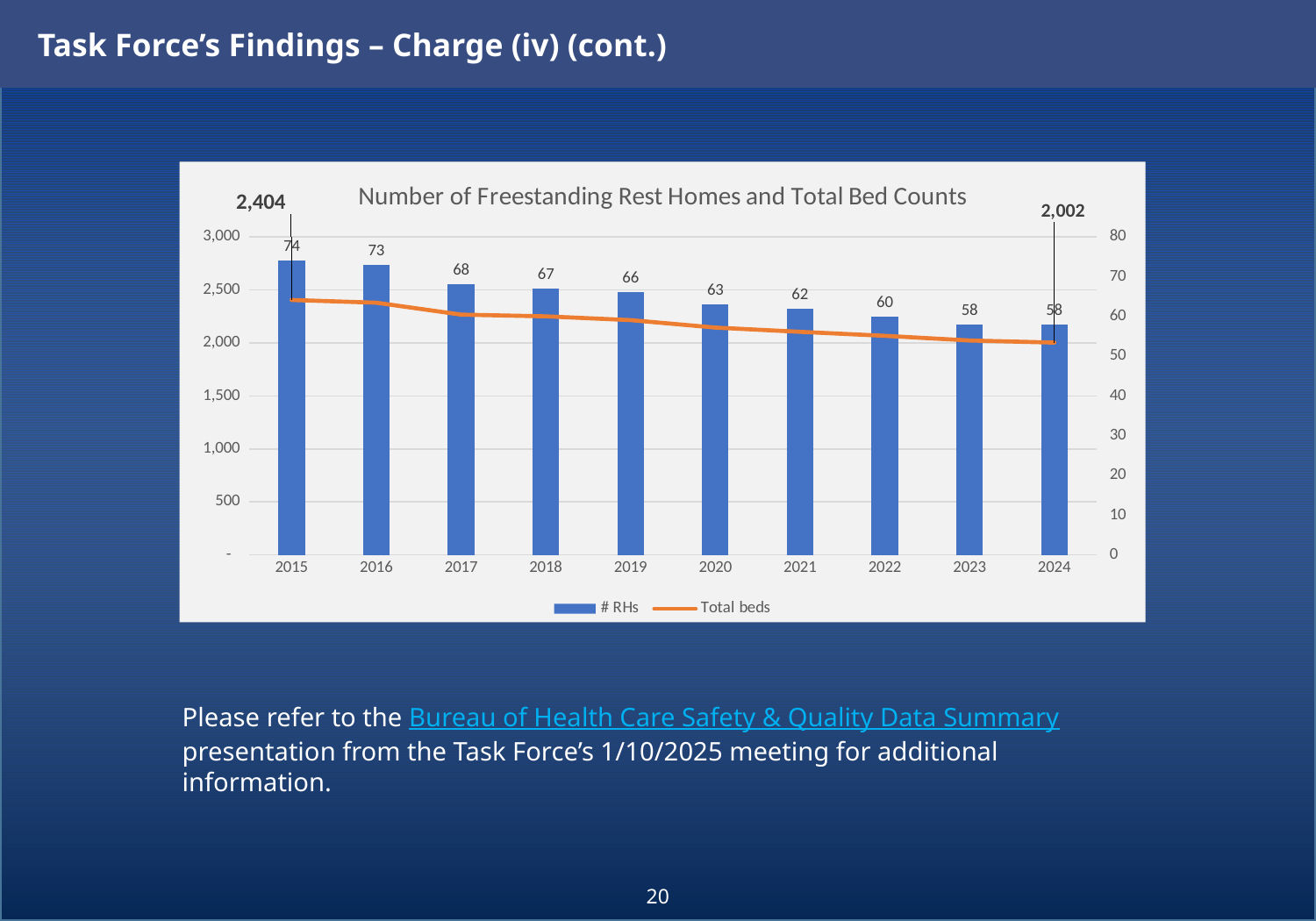
How many years are shown on the x axis? 10 What is the number of rest homes (# RHs) in 2020? 63 What is the difference in # RHs between 2015 and 2024? 16 By how much did Total beds decrease from 2015 to 2024? 402 What is the Total beds value labelled for 2015? 2,404 What is the Total beds value labelled for 2024? 2,002 Which year has the highest number of rest homes (# RHs)? 2015 How many series does the legend list? 2 Is the Total beds value for 2020 greater or less than 2,500? less Does the number of rest homes (# RHs) rise or fall from 2015 to 2024? fall What is the number of rest homes (# RHs) in 2015? 74 Which year has more rest homes (# RHs), 2017 or 2022? 2017